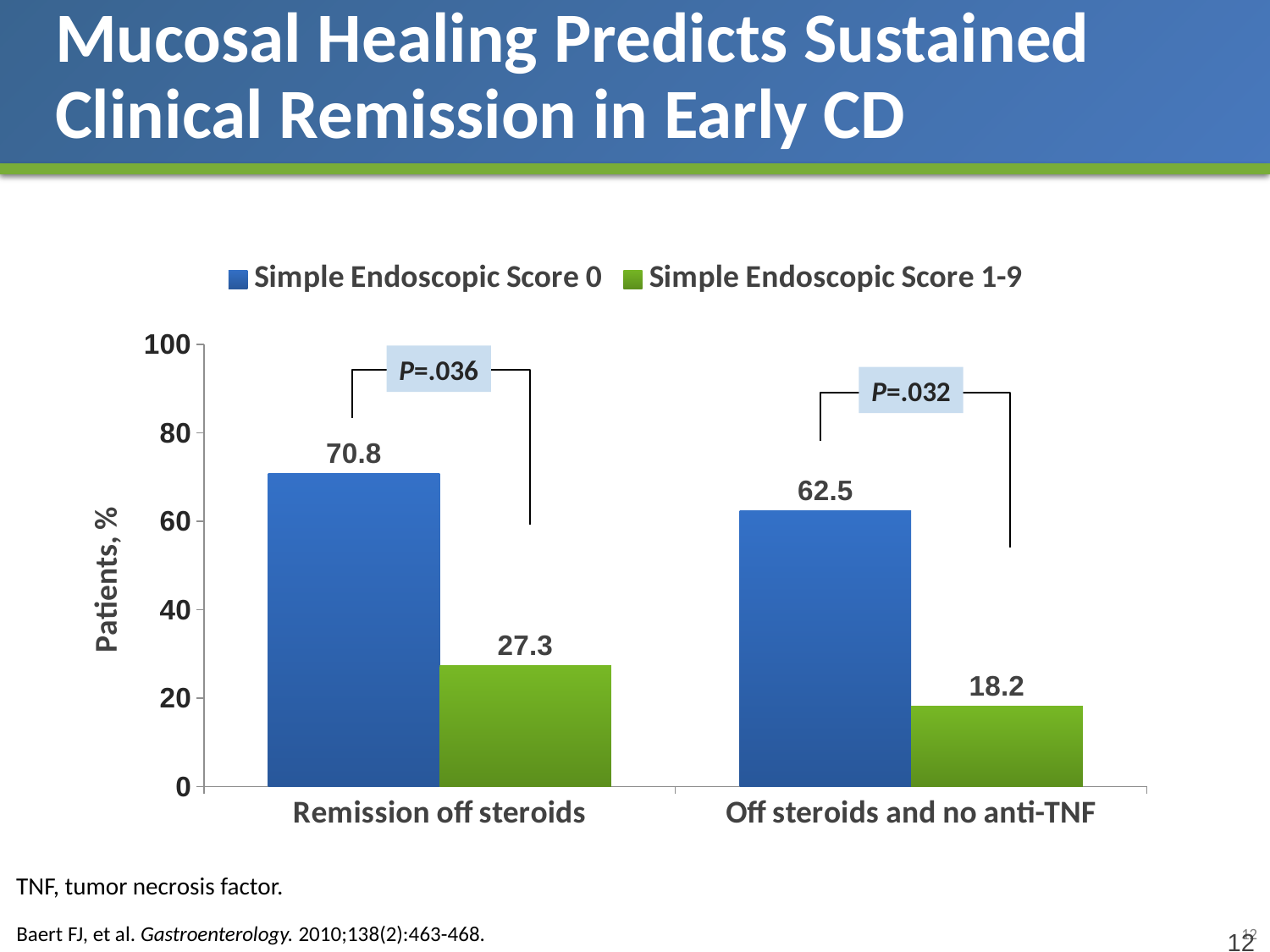
What is the P value shown above the Off steroids and no anti-TNF bars? P=.032 Which bar has the lowest value on the chart? Simple Endoscopic Score 1-9, Off steroids and no anti-TNF Which bar has the highest value on the chart? Simple Endoscopic Score 0, Remission off steroids What is the value for Simple Endoscopic Score 0 in the Remission off steroids category? 70.8 What kind of chart is shown on the slide? Bar chart Which is larger: the Simple Endoscopic Score 1-9 value for Remission off steroids or for Off steroids and no anti-TNF? Remission off steroids What is the difference between the Simple Endoscopic Score 0 and Simple Endoscopic Score 1-9 values in the Remission off steroids category? 43.5 What is the value for Simple Endoscopic Score 0 in the Off steroids and no anti-TNF category? 62.5 What is the value for Simple Endoscopic Score 1-9 in the Off steroids and no anti-TNF category? 18.2 What is the value for Simple Endoscopic Score 1-9 in the Remission off steroids category? 27.3 What is the difference between the Simple Endoscopic Score 0 and Simple Endoscopic Score 1-9 values in the Off steroids and no anti-TNF category? 44.3 How many series does the legend list? 2